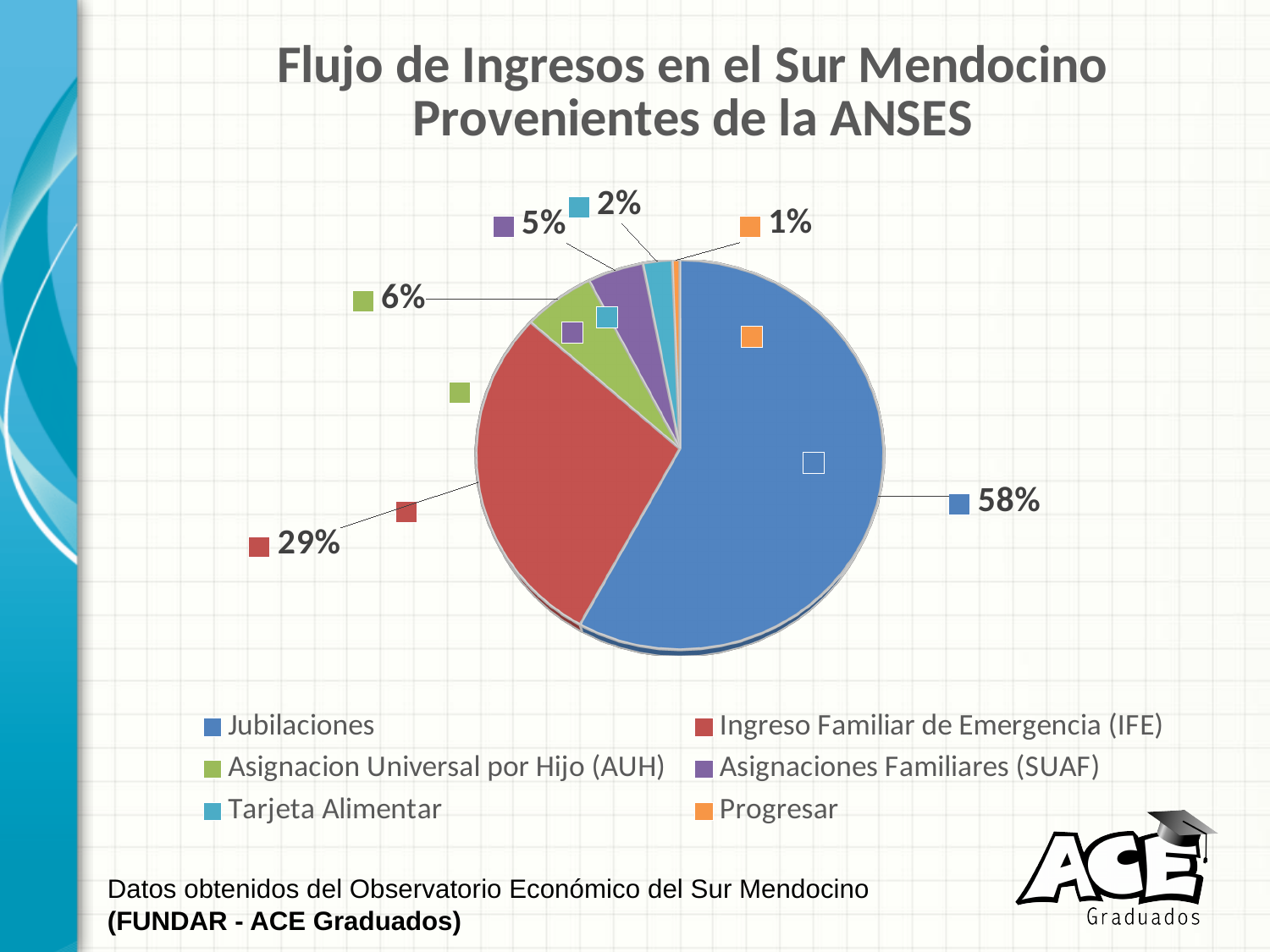
What share of the pie does Ingreso Familiar de Emergencia (IFE) represent? 29% What kind of chart is shown on the slide? pie chart What share of the pie does Jubilaciones represent? 58% What is the title of the chart? Flujo de Ingresos en el Sur Mendocino Provenientes de la ANSES How many categories does the legend list? 6 What share of the pie does Progresar represent? 1% What is the difference between the shares of Jubilaciones and Ingreso Familiar de Emergencia (IFE)? 29% Which category has the smallest slice of the pie? Progresar Which category has the largest slice of the pie? Jubilaciones